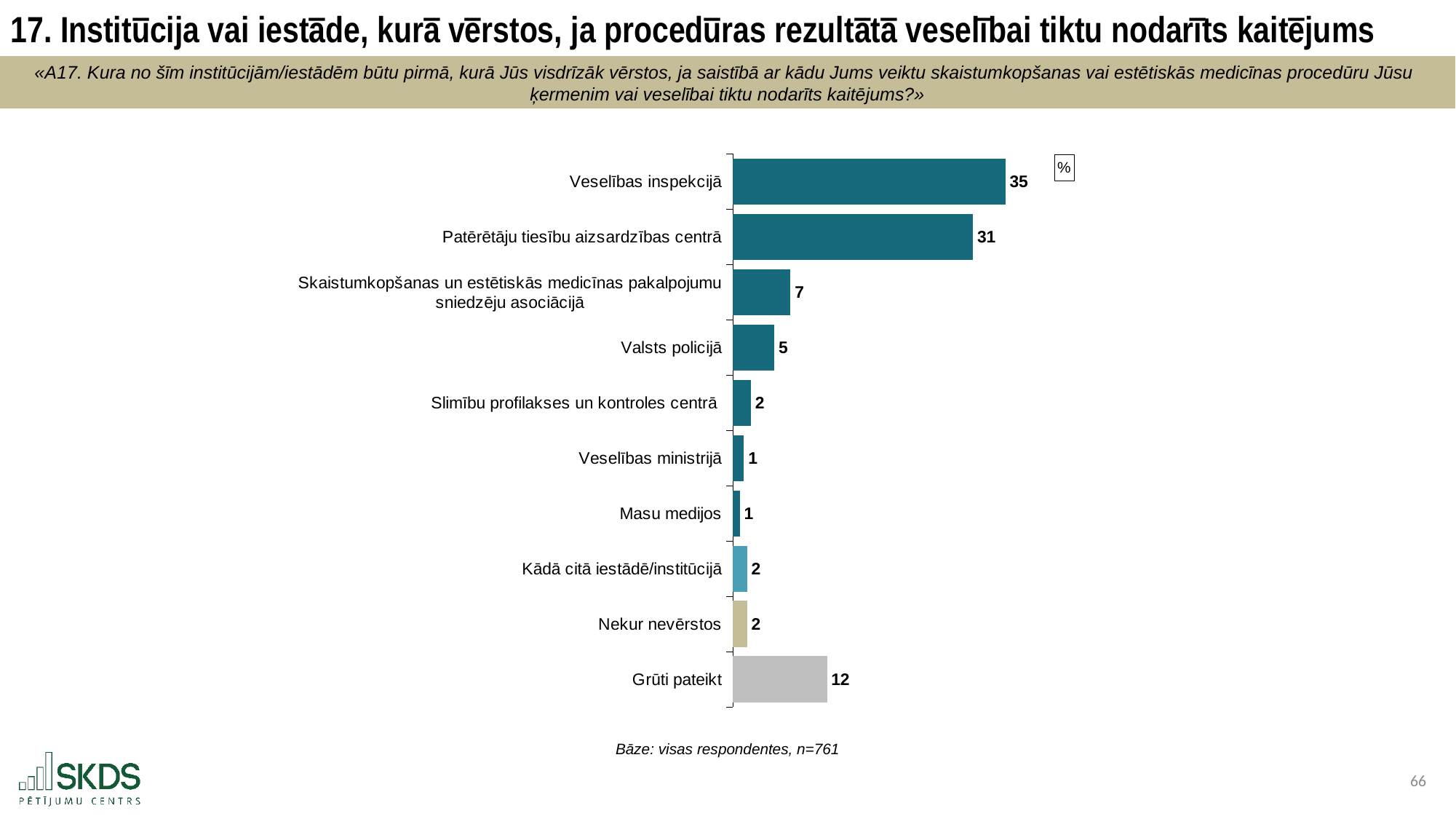
How many categories are shown in the chart? 10 What kind of chart is shown on the slide? Bar chart What is the base (n) stated below the chart? n=761 Which is larger: the value for Skaistumkopšanas un estētiskās medicīnas pakalpojumu sniedzēju asociācijā or the value for Grūti pateikt? Grūti pateikt What is the value for Nekur nevērstos? 2 Which category has the highest value? Veselības inspekcijā What is the value for Valsts policijā? 5 What is the difference between the values for Valsts policijā and Veselības ministrijā? 4 What is the value for Grūti pateikt? 12 What is the difference between the values for Veselības inspekcijā and Patērētāju tiesību aizsardzības centrā? 4 What is the value for Veselības inspekcijā? 35 What is the value for Patērētāju tiesību aizsardzības centrā? 31